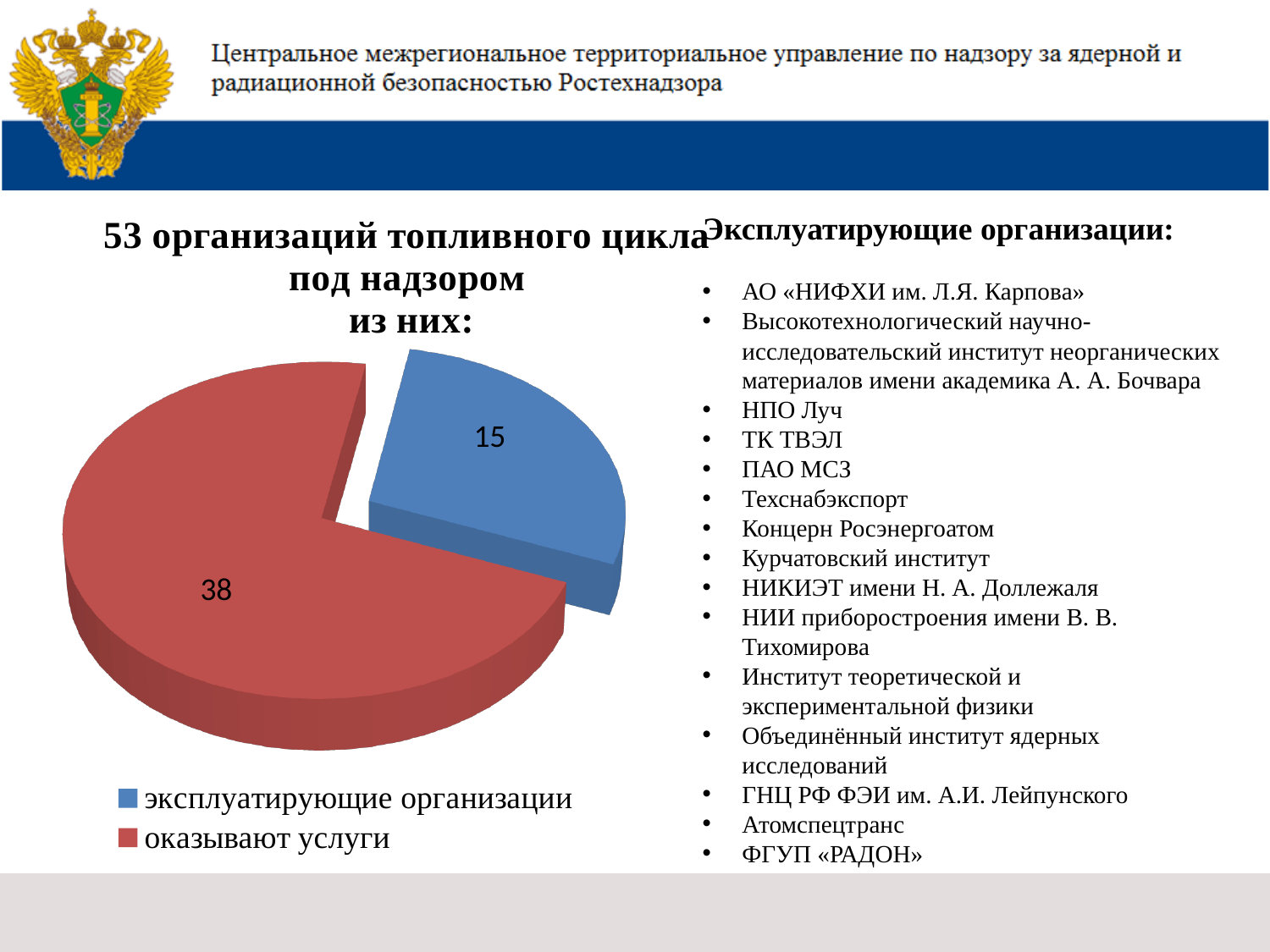
What colour is the slice for «эксплуатирующие организации»? blue What type of chart is shown on the slide? pie chart What colour is the slice for «оказывают услуги»? red How many slices does the pie chart have? 2 What is the total of the two slices in the pie chart? 53 Which category has the smallest slice in the pie chart? эксплуатирующие организации Which category has the largest slice in the pie chart? оказывают услуги What is the value for «оказывают услуги» in the pie chart? 38 Which is larger: the value for «эксплуатирующие организации» or the value for «оказывают услуги»? оказывают услуги What is the value for «эксплуатирующие организации» in the pie chart? 15 What is the difference between the values for «оказывают услуги» and «эксплуатирующие организации»? 23 How many entries does the legend of the pie chart list? 2